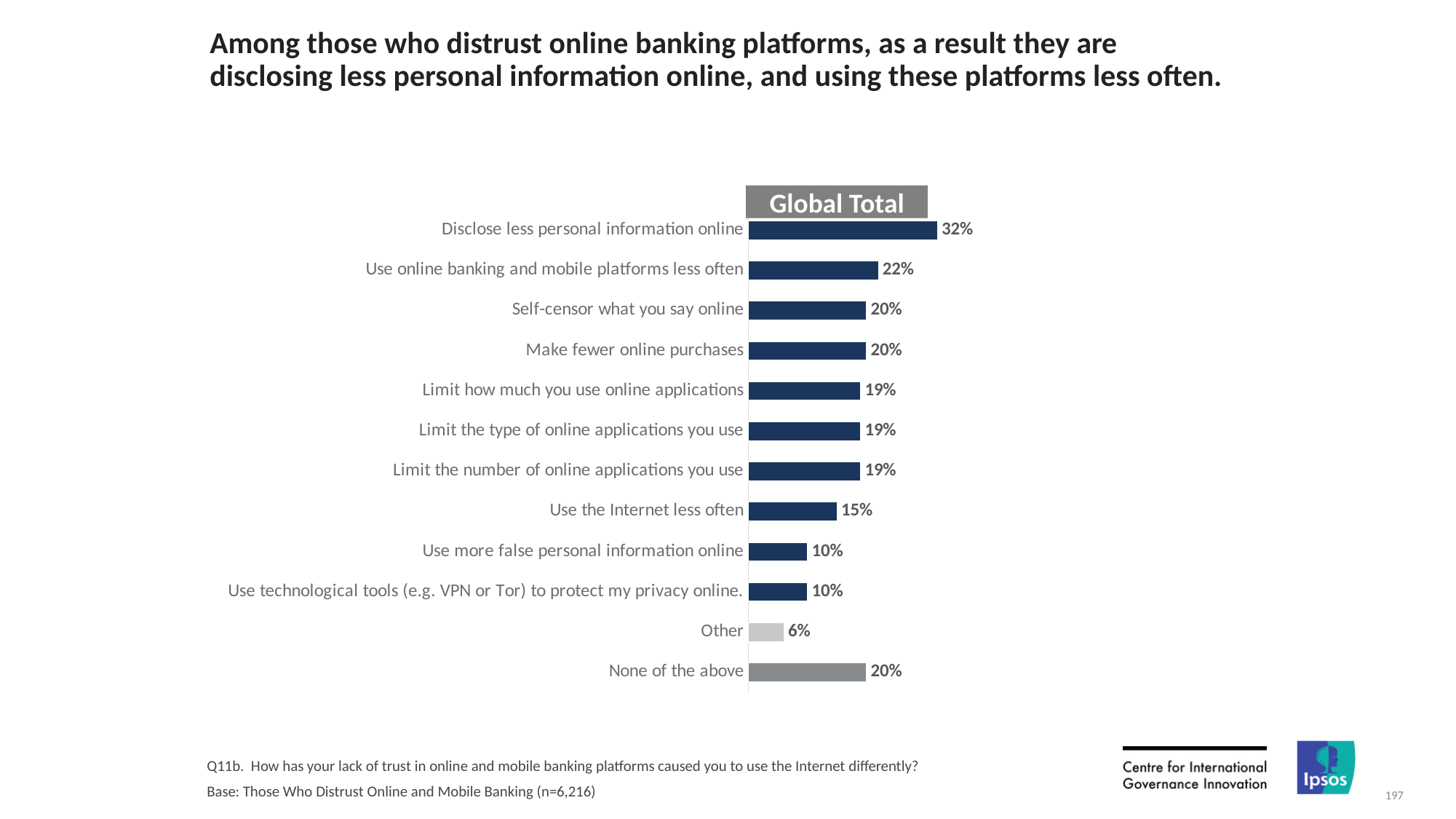
What is the value for 'Use online banking and mobile platforms less often'? 22% What kind of chart is shown on the slide? Bar chart Which category has the highest value in the chart? Disclose less personal information online What percentage say they use the Internet less often? 15% What is the value for 'Use technological tools (e.g. VPN or Tor) to protect my privacy online.'? 10% What is the difference between 'None of the above' and 'Other'? 14% What is the difference between 'Disclose less personal information online' and 'Use online banking and mobile platforms less often'? 10% Which category has the lowest value in the chart? Other Which is larger: 'Use the Internet less often' or 'Use more false personal information online'? Use the Internet less often What percentage of respondents say they disclose less personal information online? 32% What is the heading shown above the bars in the chart? Global Total How many categories are shown in the chart? 12